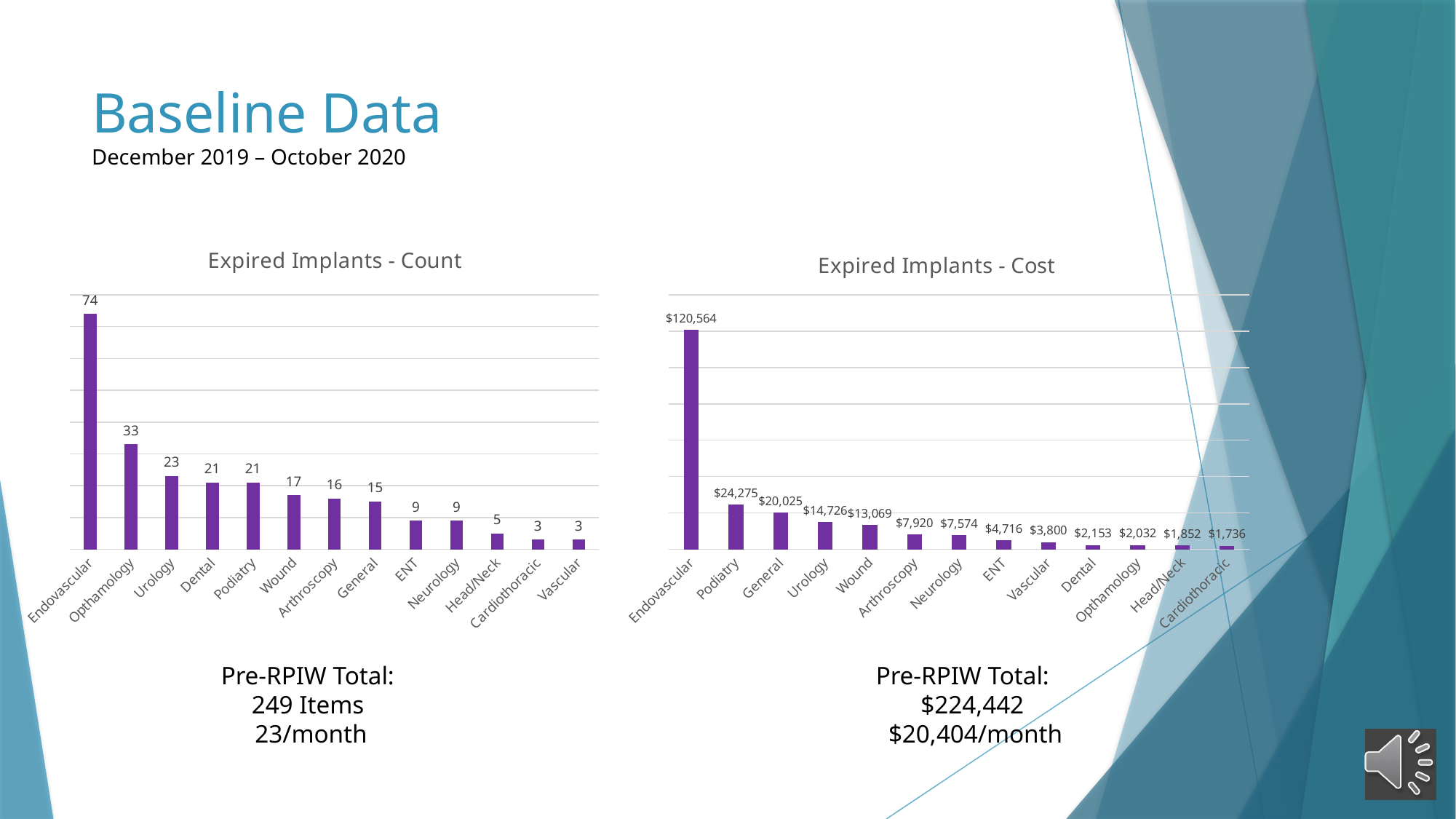
In the Expired Implants - Cost chart, which is larger, General or Urology? General In the Expired Implants - Count chart, what is the difference between Opthamology and Urology? 10 In the Expired Implants - Cost chart, which category has the lowest value? Cardiothoracic In the Expired Implants - Cost chart, what is the value for Podiatry? $24,275 What kind of chart is the Expired Implants - Cost chart? Bar chart In the Expired Implants - Count chart, what is the value for Wound? 17 In the Expired Implants - Count chart, which category has the highest value? Endovascular In the Expired Implants - Cost chart, what is the value for Cardiothoracic? $1,736 In the Expired Implants - Count chart, how many categories are shown? 13 In the Expired Implants - Count chart, do the values rise or fall from left to right along the x axis? Fall In the Expired Implants - Count chart, what is the value for Endovascular? 74 In the Expired Implants - Cost chart, what is the difference between Endovascular and Podiatry? $96,289